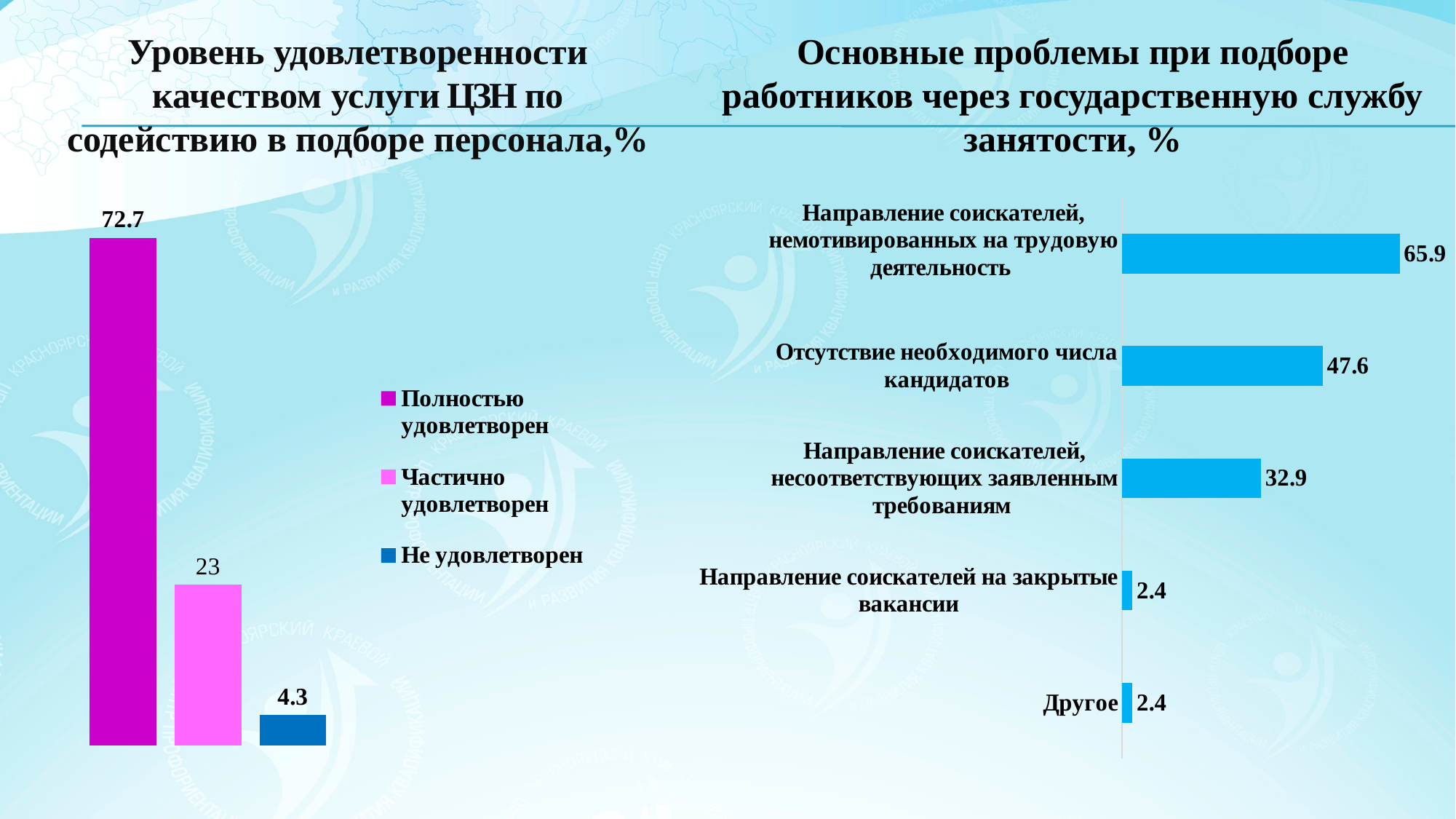
In the right chart (main problems in recruiting), what is the value for "Отсутствие необходимого числа кандидатов"? 47.6 In the left chart (satisfaction level), what is the value for "Не удовлетворен"? 4.3 In the right chart (main problems in recruiting), what is the value for "Другое"? 2.4 In the left chart (satisfaction level), what is the value for "Частично удовлетворен"? 23 In the left chart (satisfaction level), which is larger: "Частично удовлетворен" or "Не удовлетворен"? Частично удовлетворен In the right chart (main problems in recruiting), which category has the highest value? Направление соискателей, немотивированных на трудовую деятельность In the right chart (main problems in recruiting), how many categories are shown? 5 In the right chart (main problems in recruiting), what is the difference between "Отсутствие необходимого числа кандидатов" and "Направление соискателей, несоответствующих заявленным требованиям"? 14.7 In the left chart (satisfaction level), how many entries does the legend list? 3 What kind of chart is the right chart (main problems in recruiting)? Bar chart In the left chart (satisfaction level), what is the value for "Полностью удовлетворен"? 72.7 In the left chart (satisfaction level), what is the difference between "Полностью удовлетворен" and "Частично удовлетворен"? 49.7